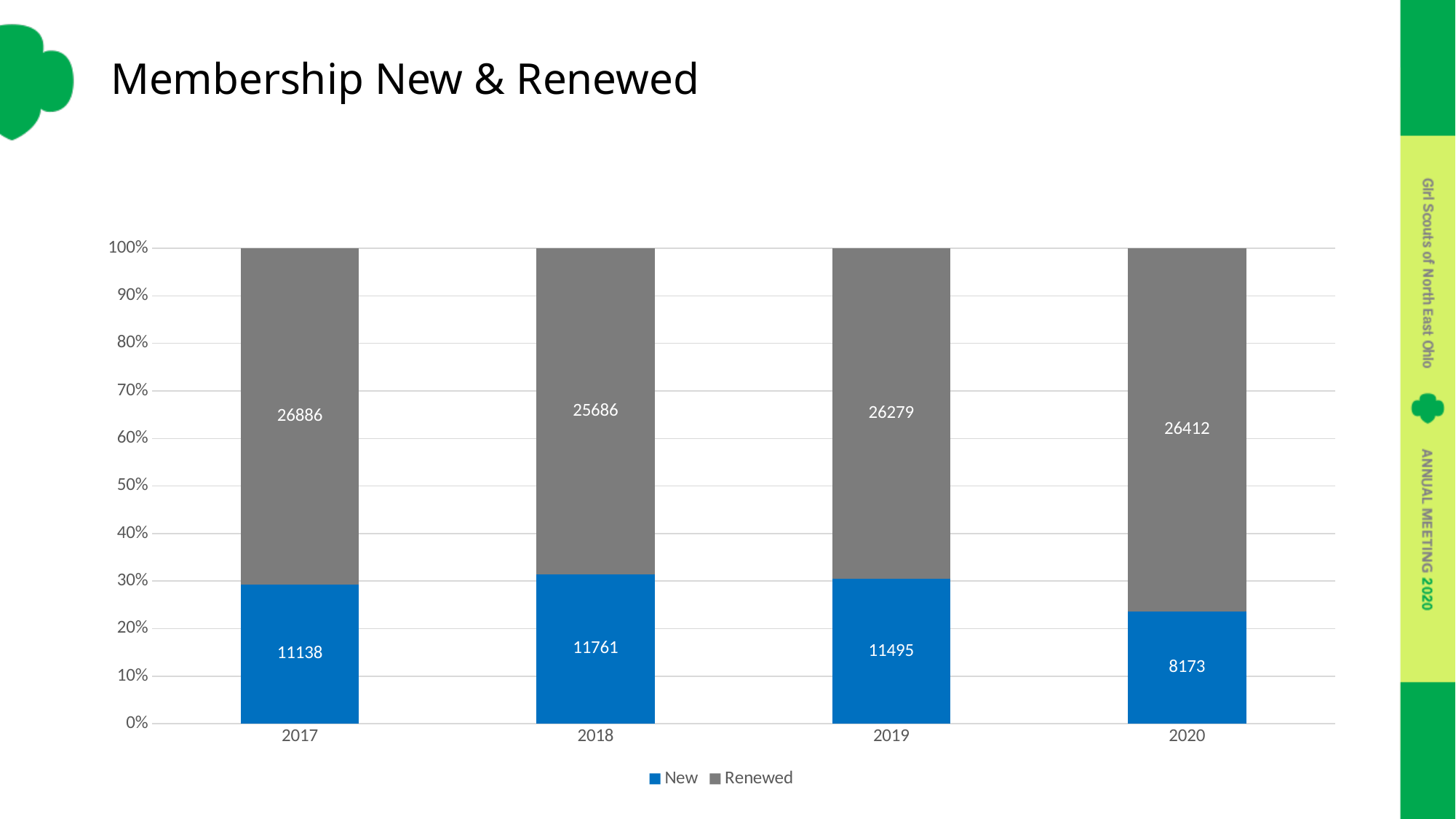
What is the difference between Renewed and New in 2020? 18239 Which year has the highest New value? 2018 What is the value for Renewed in 2020? 26412 How many series does the legend list? 2 Is the New share of the 2020 bar greater or less than 30%? less What is the value for Renewed in 2018? 25686 Which year has the highest Renewed value? 2017 Which is larger, the New value in 2019 or the New value in 2020? 2019 What is the total of New and Renewed in 2017? 38024 How many years are shown on the x axis? 4 What is the value for New in 2017? 11138 Which year has the lowest New value? 2020